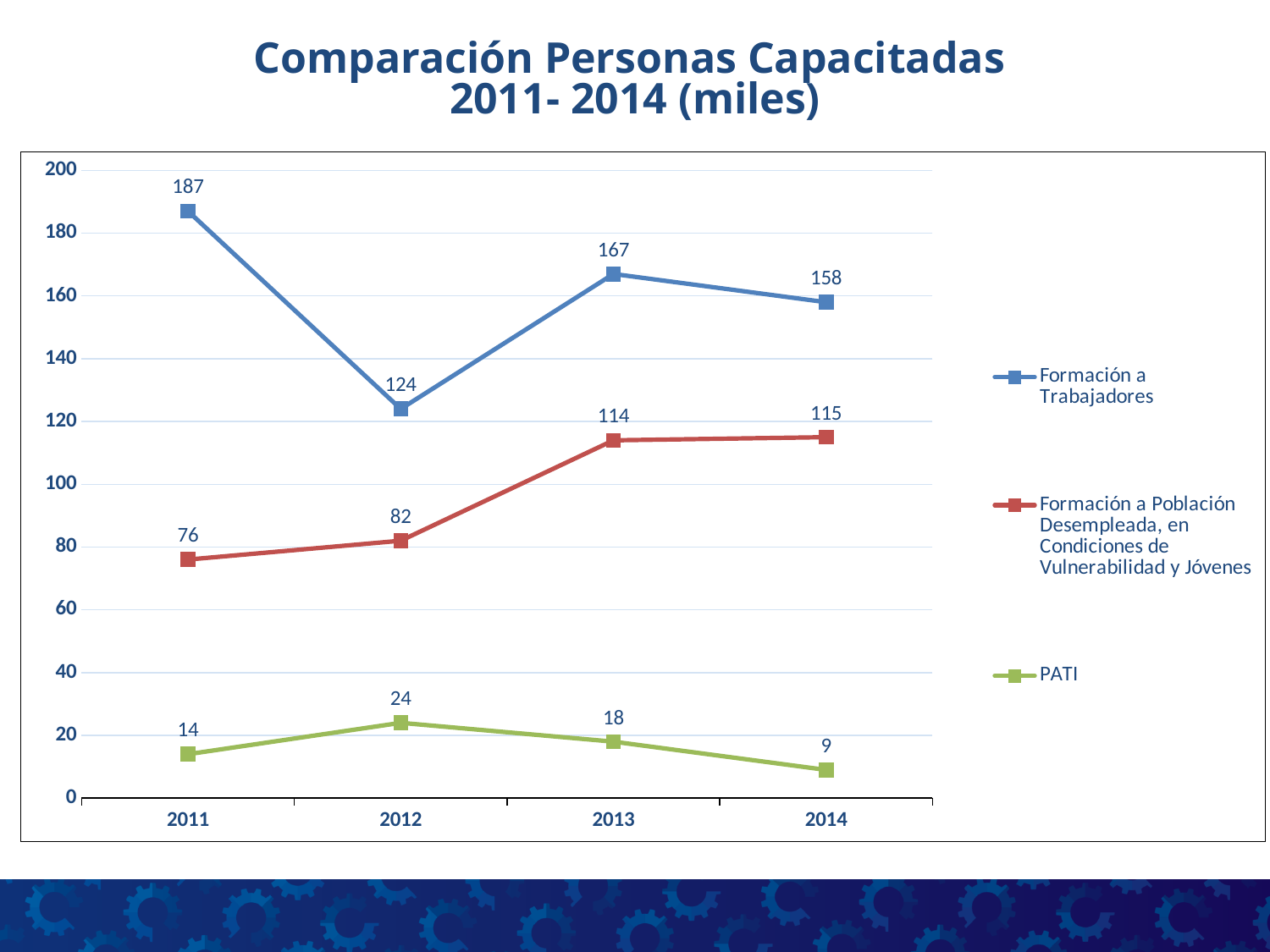
What type of chart is shown on the slide? Line chart What is the value for Formación a Población Desempleada, en Condiciones de Vulnerabilidad y Jóvenes in 2013? 114 How many years are shown on the x axis? 4 In which year is the value for Formación a Trabajadores lowest? 2012 In which year is the value for PATI highest? 2012 Which is larger in 2014: Formación a Trabajadores or PATI? Formación a Trabajadores What is the title of the chart? Comparación Personas Capacitadas 2011- 2014 (miles) What is the value for PATI in 2012? 24 How many series does the legend list? 3 Does the PATI series rise or fall from 2012 to 2014? Fall What is the value for Formación a Trabajadores in 2011? 187 What is the difference between the Formación a Trabajadores values in 2011 and 2012? 63